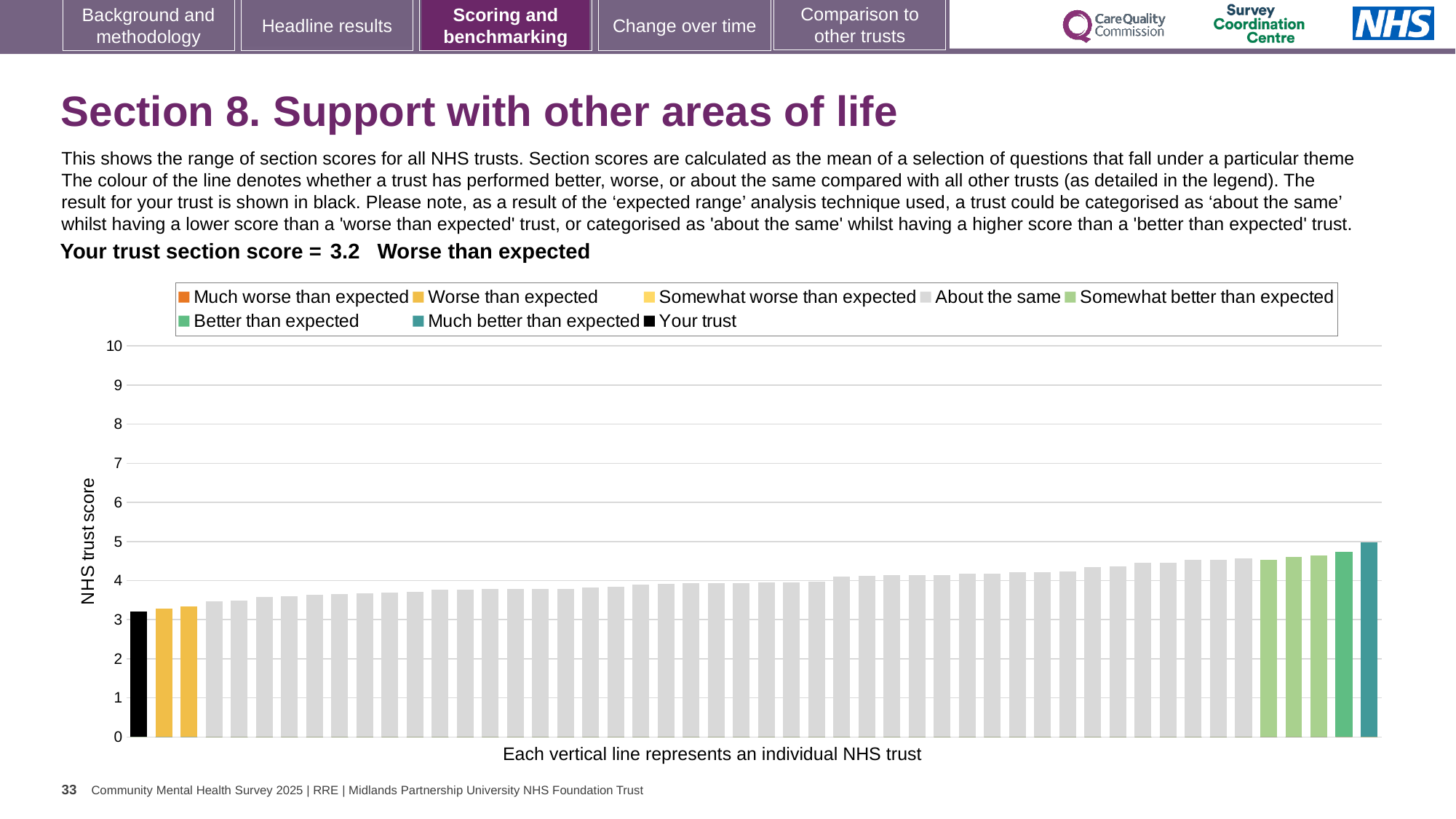
How many entries does the chart legend list? 8 Is the value for Your trust greater or less than 4? less Is the bar for Your trust taller or shorter than the 'Much better than expected' bar? shorter Which legend category does the shortest bar belong to? Your trust What is the section score for Your trust? 3.2 Is the value of the tallest bar (Much better than expected) greater or less than 4? greater What kind of chart is shown on the slide? bar chart Which legend category is Your trust placed in? Worse than expected How many bars are coloured as 'Worse than expected' (excluding Your trust)? 2 What is the label on the vertical axis of the chart? NHS trust score Do the bar values rise or fall from left to right along the x axis? rise Which legend category does the tallest bar belong to? Much better than expected